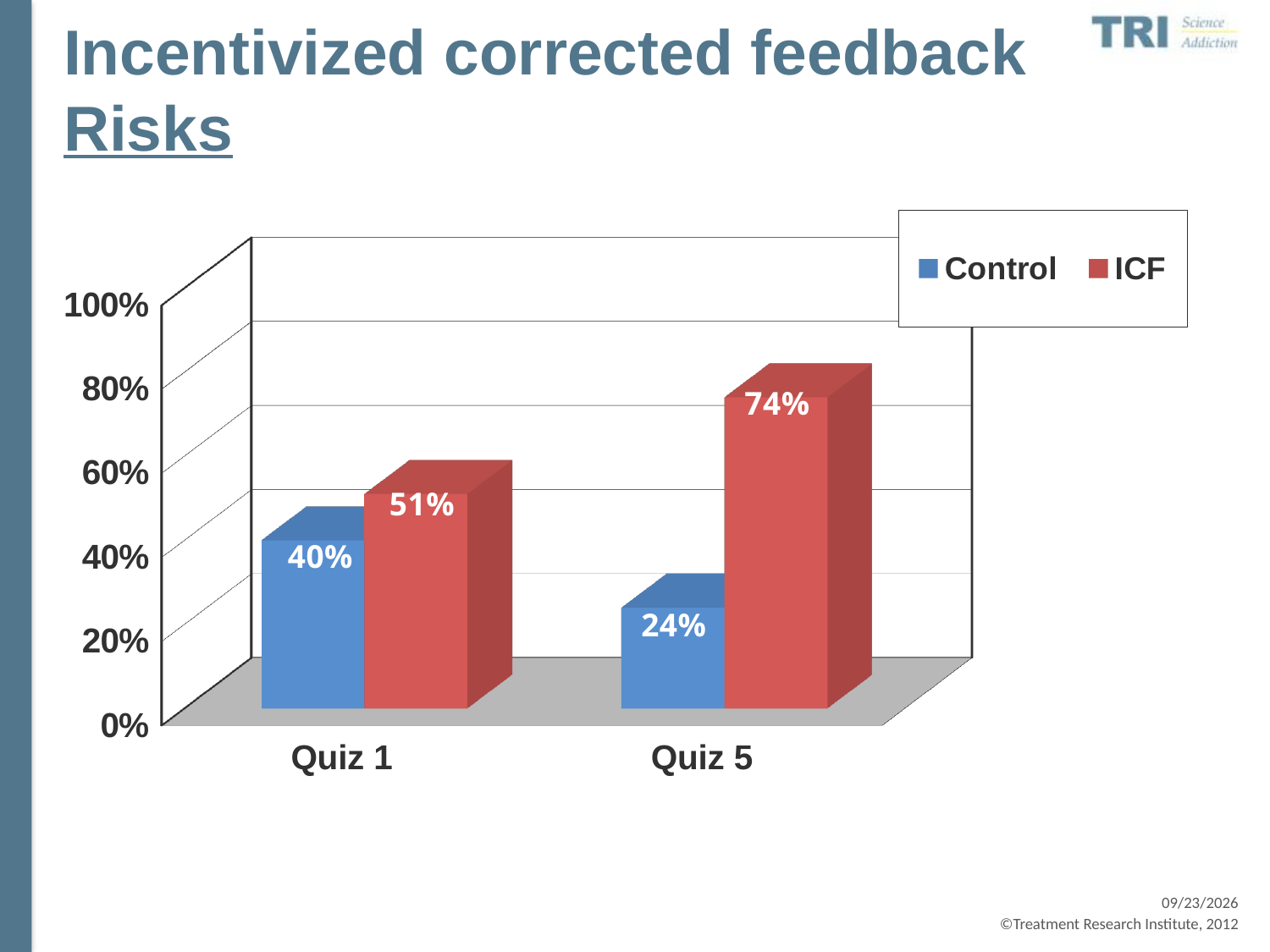
How many series does the legend list? 2 Which bar has the lowest value on the chart? Control at Quiz 5 What is the difference between ICF and Control at Quiz 1? 11% What is the value for Control at Quiz 5? 24% What is the value for ICF at Quiz 5? 74% Which is larger at Quiz 1, Control or ICF? ICF What kind of chart is shown on the slide? Bar chart What is the difference between ICF and Control at Quiz 5? 50% What is the value for ICF at Quiz 1? 51% Which bar has the highest value on the chart? ICF at Quiz 5 How many categories are shown on the x axis? 2 What is the value for Control at Quiz 1? 40%